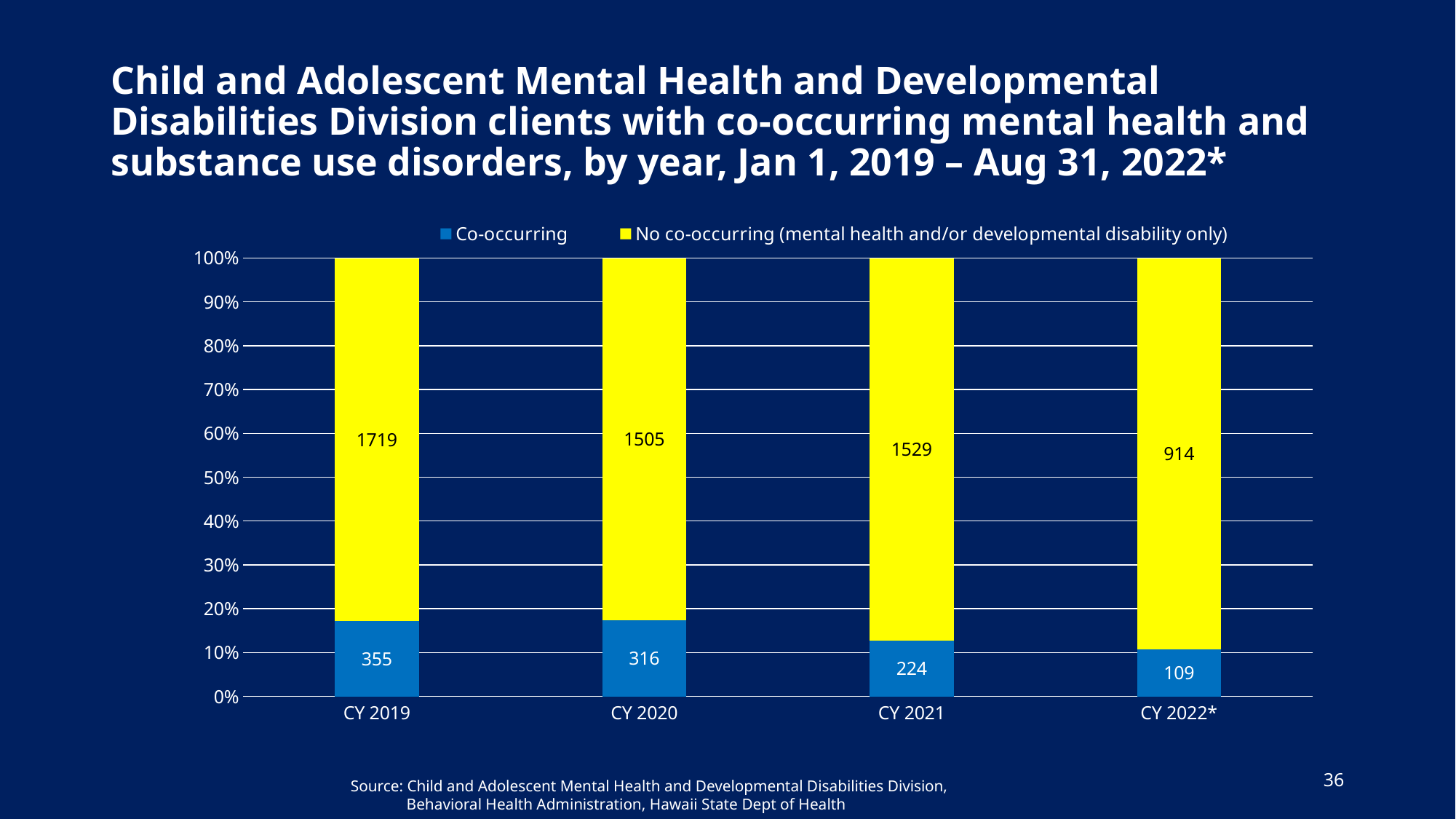
Is the Co-occurring share of the CY 2019 bar greater or less than 10%? greater Which year has the highest Co-occurring value? CY 2019 What is the Co-occurring value for CY 2019? 355 What is the total of the CY 2022* bar (Co-occurring plus No co-occurring)? 1023 How many years are shown on the x axis? 4 Which is larger, the No co-occurring value for CY 2020 or for CY 2021? CY 2021 How many series does the legend list? 2 What is the difference between the Co-occurring values for CY 2019 and CY 2020? 39 Which year has the lowest No co-occurring value? CY 2022* What is the No co-occurring value for CY 2021? 1529 What is the Co-occurring value for CY 2022*? 109 What kind of chart is shown on the slide? Stacked bar chart